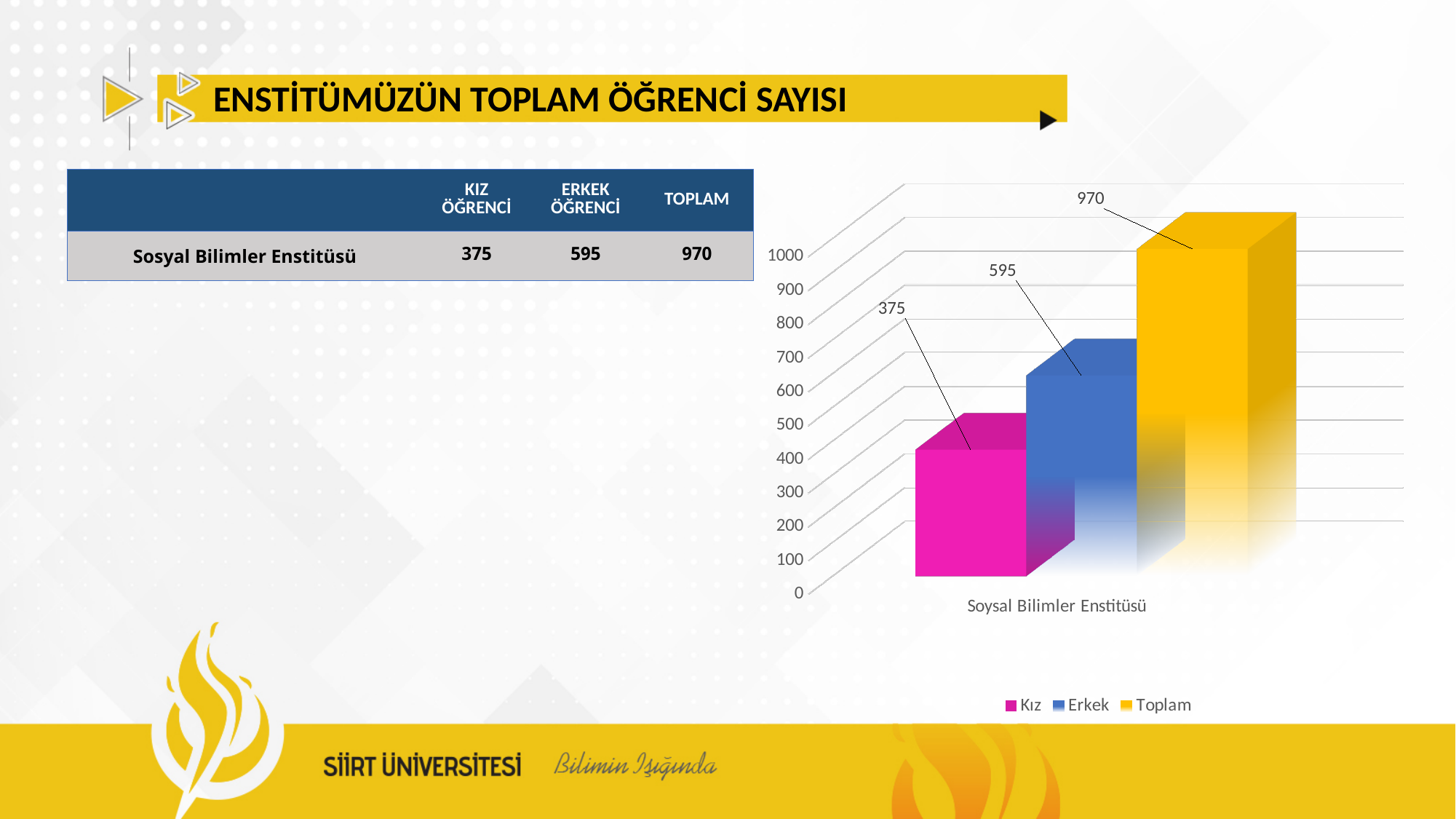
Which series has the lowest value in the chart? Kız What is the value for Erkek in the chart? 595 Which is larger, the value for Kız or the value for Erkek? Erkek Which series has the highest value in the chart? Toplam Is the value for Erkek greater or less than 500? greater What category label is shown on the x axis of the chart? Soysal Bilimler Enstitüsü What colour represents the Toplam series in the chart? yellow What is the difference between the Erkek and Kız values? 220 What is the value for Toplam in the chart? 970 What kind of chart is shown on the slide? bar chart What is the value for Kız in the chart? 375 How many series does the legend list? 3